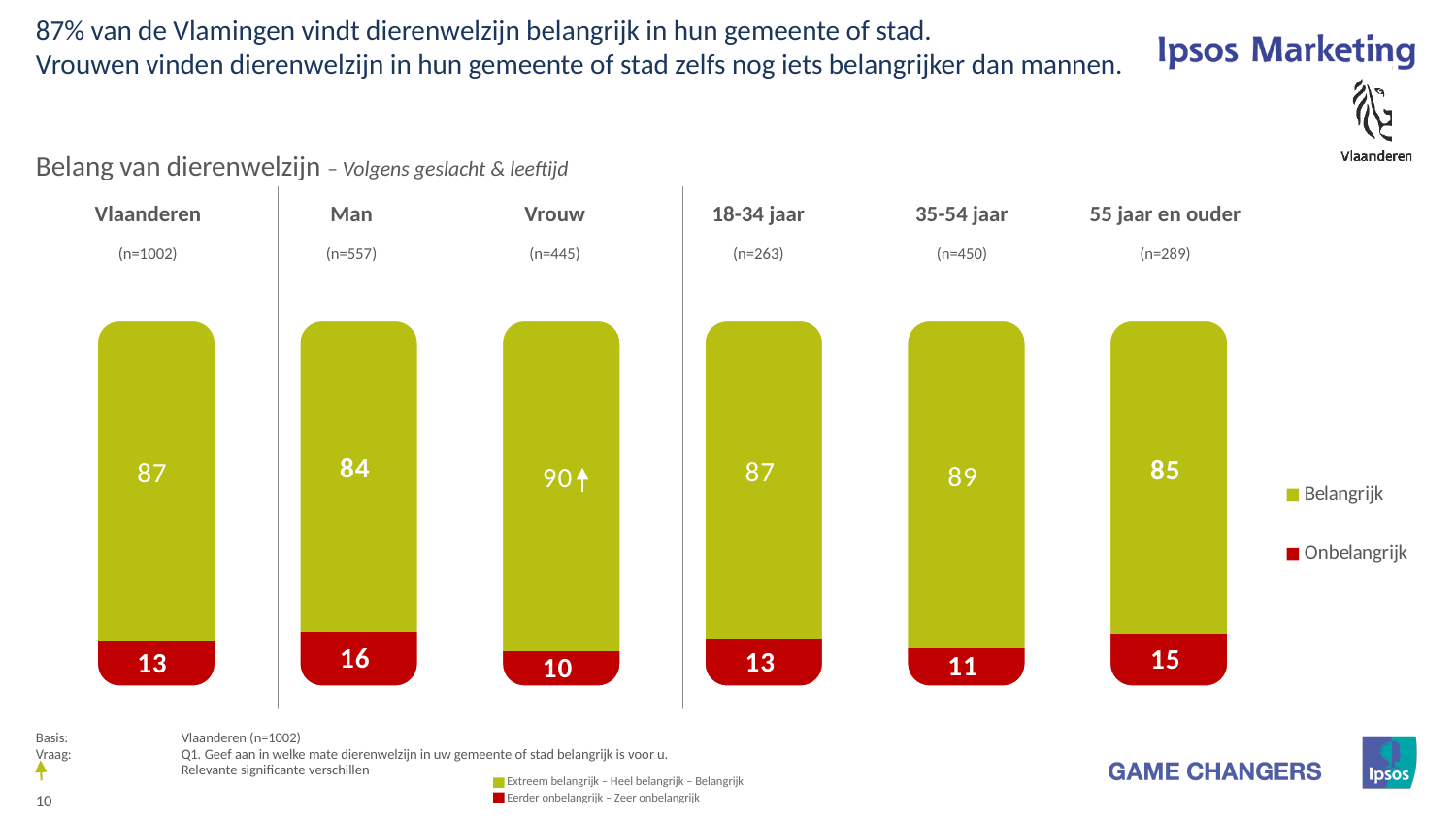
What is the total of the stacked bar for 18-34 jaar? 100 Which has a larger Onbelangrijk value, 55 jaar en ouder or 35-54 jaar? 55 jaar en ouder What is the sample size (n) shown for Vlaanderen? n=1002 How many series does the legend list? 2 What is the Belangrijk value for 35-54 jaar? 89 How many categories are shown in the chart? 6 What is the Onbelangrijk value for Man? 16 Which category has the lowest Onbelangrijk value? Vrouw What is the Belangrijk value for Vrouw? 90 Which category has the highest Belangrijk value? Vrouw What is the difference between the Belangrijk values for Vrouw and Man? 6 What kind of chart is shown on the slide? Stacked bar chart